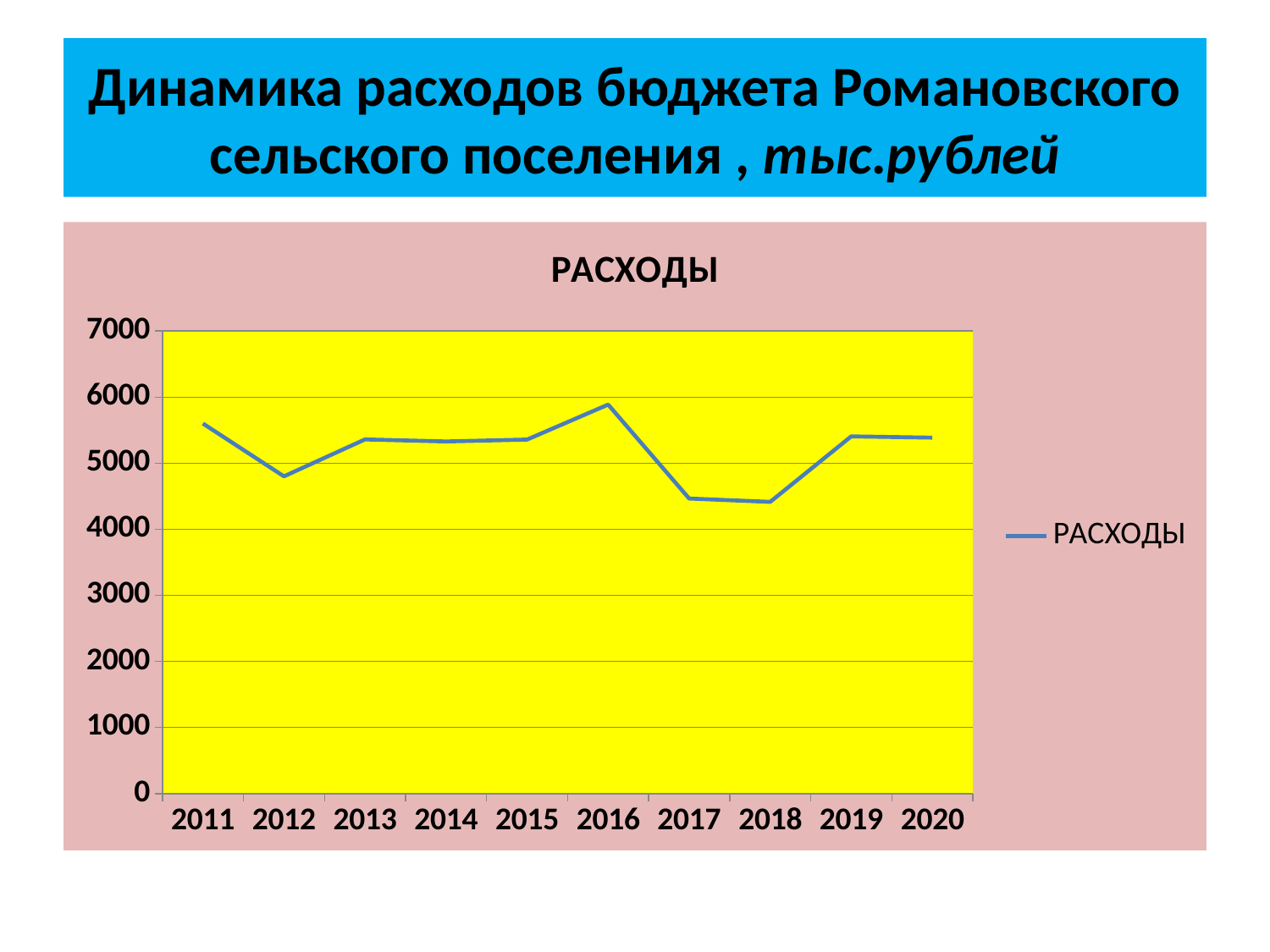
What kind of chart is shown on the slide? line chart Which year has the highest value for РАСХОДЫ? 2016 Is the value for 2017 greater or less than 5000? less Which is larger, the value for 2016 or the value for 2012? 2016 Is the value for 2018 greater or less than 4000? greater How many years are plotted along the x axis? 10 Is the value for 2016 greater or less than 5000? greater Does the value rise or fall from 2016 to 2017? fall How many series does the legend list? 1 What is the title shown above the chart's plot area? РАСХОДЫ